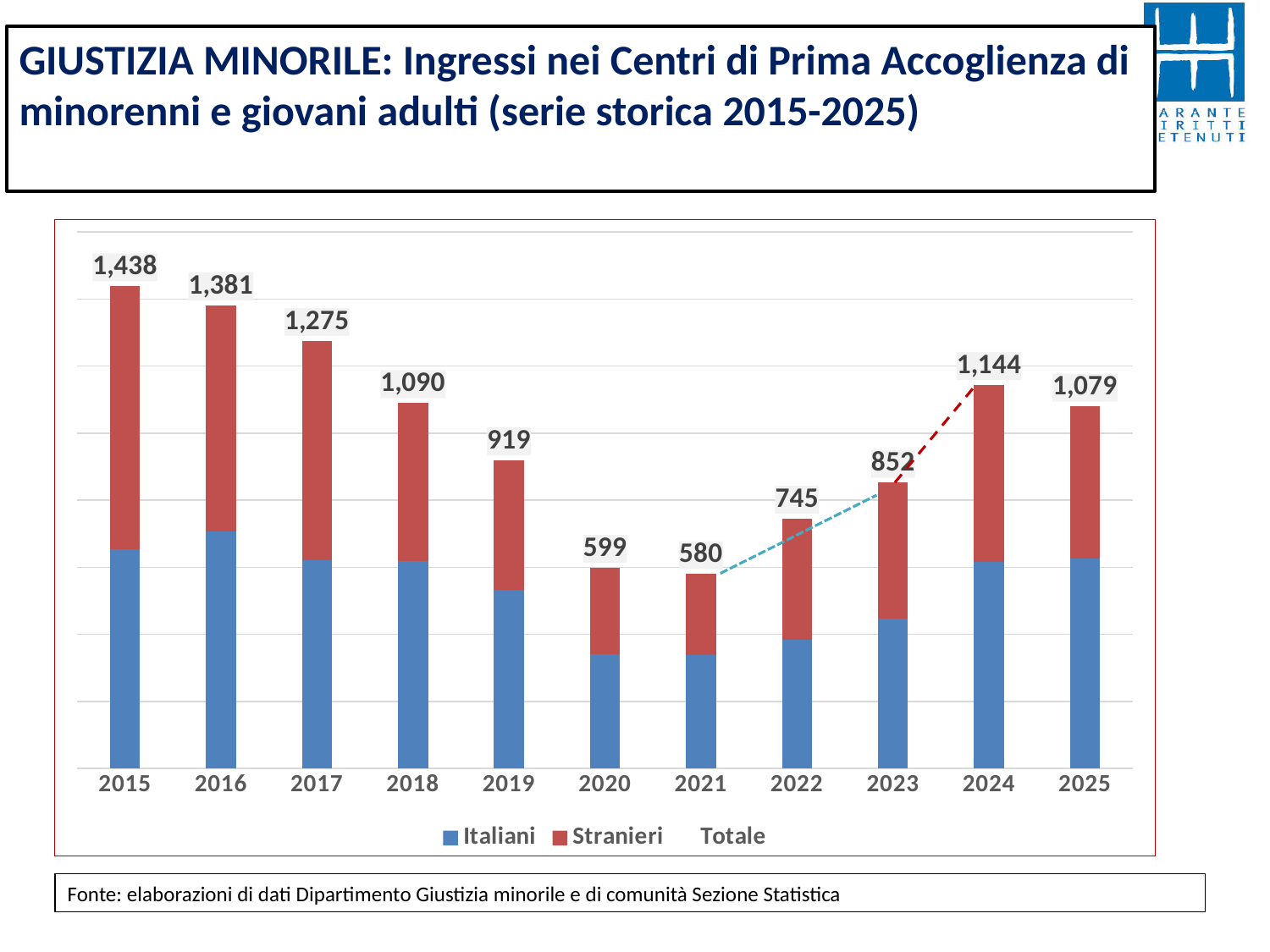
What kind of chart is shown on the slide? Stacked bar chart Do the totals rise or fall from 2015 to 2021? Fall What is the total value shown for 2015? 1,438 What is the difference between the totals for 2015 and 2016? 57 What is the total value shown for 2021? 580 How many series does the legend list? 3 What is the difference between the totals for 2024 and 2025? 65 Which year has the highest total? 2015 How many years are shown on the x axis? 11 Which year has a larger total, 2019 or 2022? 2019 What is the total value shown for 2024? 1,144 Which year has the lowest total? 2021